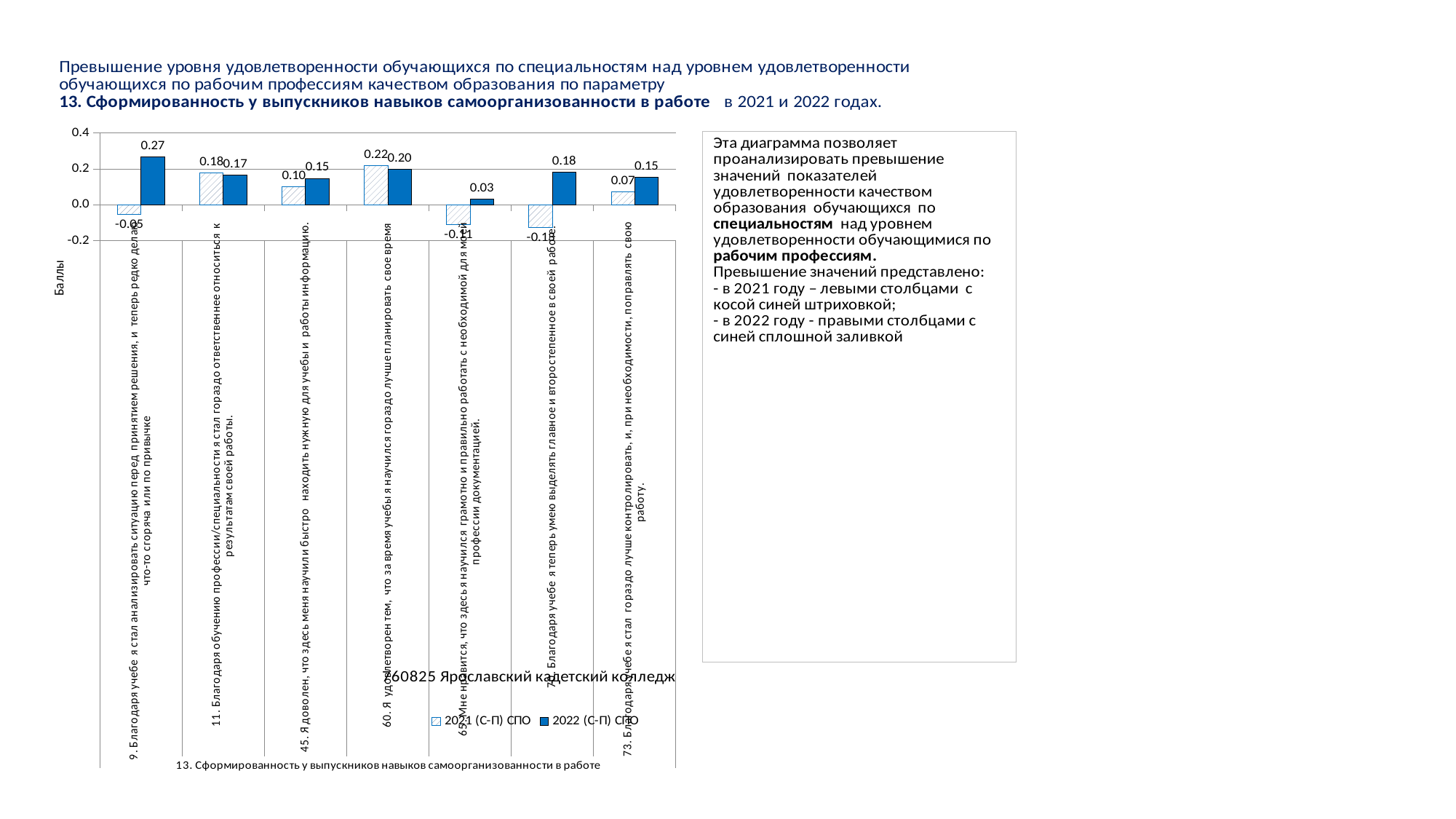
What are the two series names listed in the chart legend? 2021 (С-П) СПО and 2022 (С-П) СПО What is the 2022 (С-П) СПО value for statement 9 (Благодаря учебе я стал анализировать ситуацию перед принятием решения...)? 0.27 For statement 11 (Благодаря обучению профессии/специальности я стал гораздо ответственнее относиться к результатам своей работы), which series has the larger value, 2021 (С-П) СПО or 2022 (С-П) СПО? 2021 (С-П) СПО How many series does the chart legend list? 2 Which statement has the lowest 2022 (С-П) СПО value? 65. Мне нравится, что здесь я научился грамотно и правильно работать с необходимой для моей профессии документацией What is the 2022 (С-П) СПО value for statement 73 (Благодаря учебе я стал гораздо лучше контролировать... работу)? 0.15 Which statement has the highest 2022 (С-П) СПО value? 9. Благодаря учебе я стал анализировать ситуацию перед принятием решения, и теперь редко делаю что-то сгоряча или по привычке What is the 2021 (С-П) СПО value for statement 65 (Мне нравится, что здесь я научился грамотно и правильно работать с необходимой для моей профессии документацией)? -0.11 How many categories (statements) are plotted along the x axis? 7 What type of chart is shown on the slide? bar chart What is the 2021 (С-П) СПО value for statement 60 (Я удовлетворен тем, что за время учебы я научился гораздо лучше планировать свое время)? 0.22 For statement 9, how much higher is the 2022 (С-П) СПО value than the 2021 (С-П) СПО value? 0.32